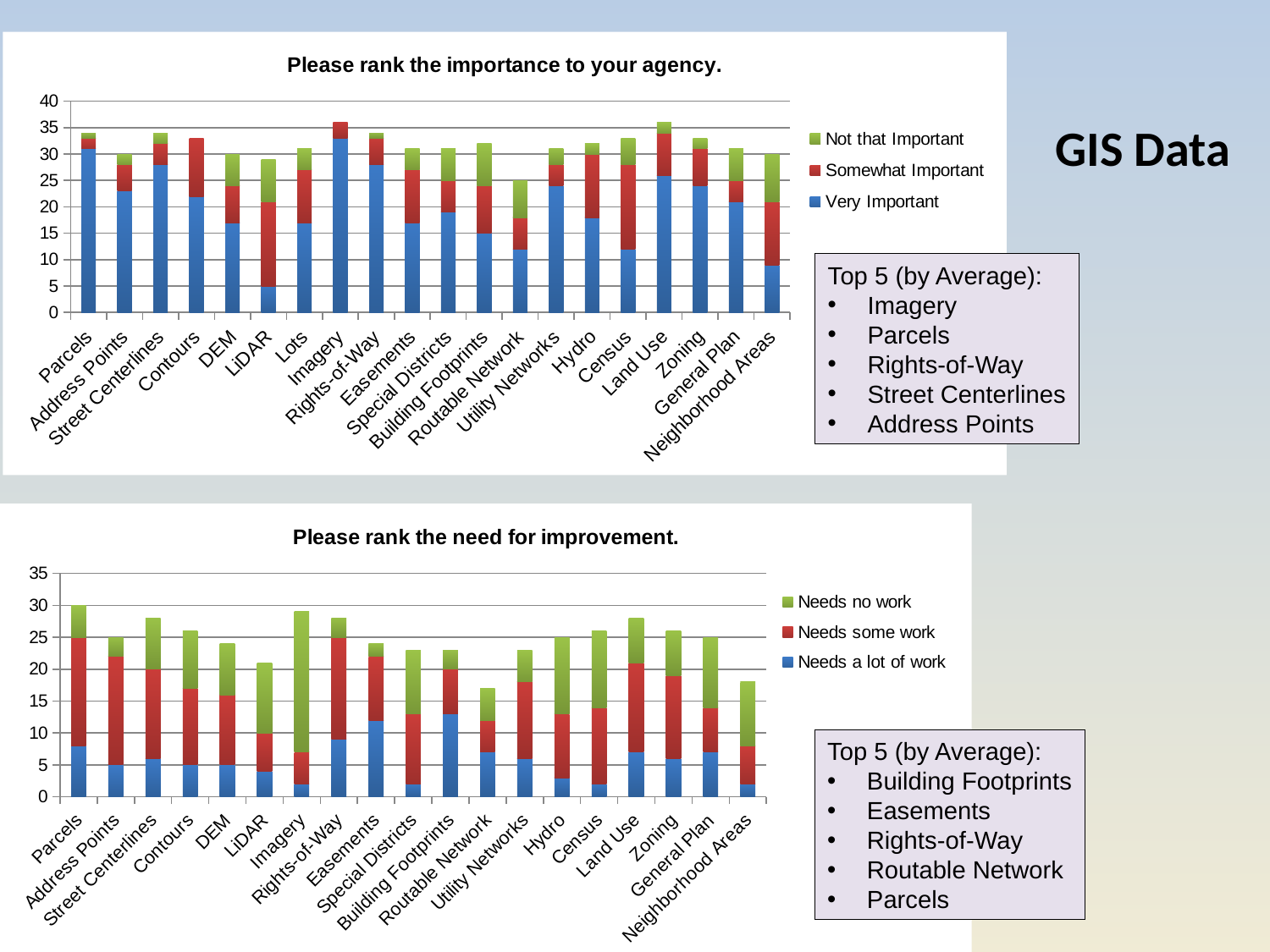
In the top chart ("Please rank the importance to your agency."), how many categories are shown on the x axis? 20 In the bottom chart ("Please rank the need for improvement."), which category has the lowest total bar height? Routable Network In the top chart ("Please rank the importance to your agency."), which has the larger Very Important value, Imagery or LiDAR? Imagery What kind of chart is the top chart titled "Please rank the importance to your agency."? Stacked bar chart In the bottom chart ("Please rank the need for improvement."), how many categories are shown on the x axis? 19 In the top chart ("Please rank the importance to your agency."), which category has the lowest total bar height? Routable Network In the bottom chart ("Please rank the need for improvement."), is the total bar height for Routable Network greater or less than 20? less In the bottom chart ("Please rank the need for improvement."), which has the larger Needs a lot of work value, Building Footprints or Neighborhood Areas? Building Footprints How many series does the legend of the top chart ("Please rank the importance to your agency.") list? 3 In the top chart ("Please rank the importance to your agency."), is the Very Important value for Imagery greater or less than 30? greater What are the three legend entries of the bottom chart ("Please rank the need for improvement.")? Needs no work, Needs some work, Needs a lot of work What is the title of the top chart on the slide? Please rank the importance to your agency.